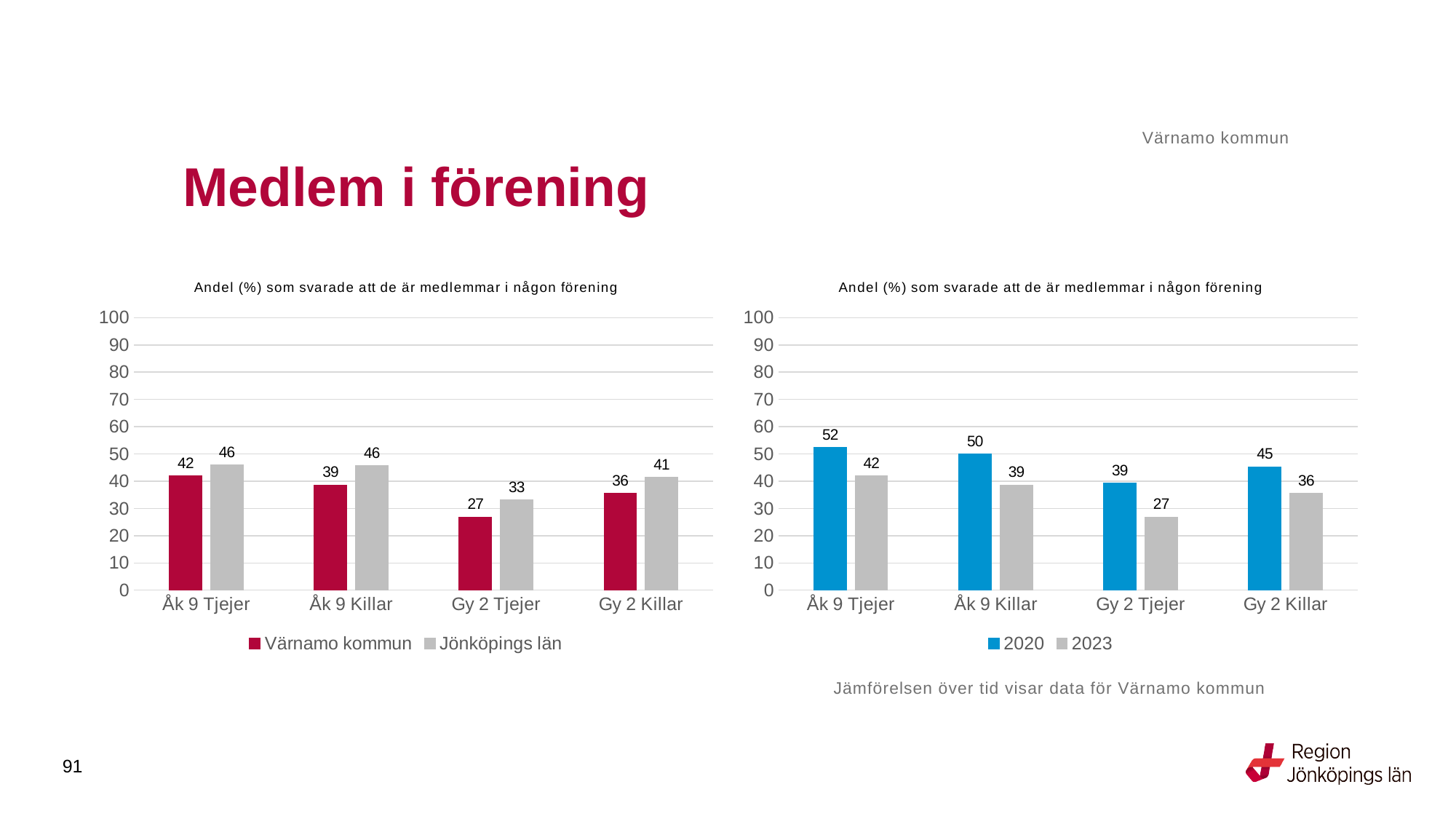
In the right chart, which category has the highest value for 2020? Åk 9 Tjejer In the left chart, what is the value for Värnamo kommun for Åk 9 Tjejer? 42 In the left chart, what is the value for Jönköpings län for Gy 2 Tjejer? 33 In the left chart, how many series does the legend list? 2 In the right chart, which is larger for Åk 9 Tjejer: 2020 or 2023? 2020 How many categories are shown on the x axis of the right chart? 4 In the left chart, what is the difference between Jönköpings län and Värnamo kommun for Gy 2 Killar? 5 What type of chart is the left chart? Bar chart In the left chart, which category has the lowest value for Värnamo kommun? Gy 2 Tjejer In the right chart, what is the value for 2020 for Åk 9 Killar? 50 In the right chart, what is the value for 2023 for Gy 2 Killar? 36 In the right chart, what is the difference between 2020 and 2023 for Gy 2 Tjejer? 12